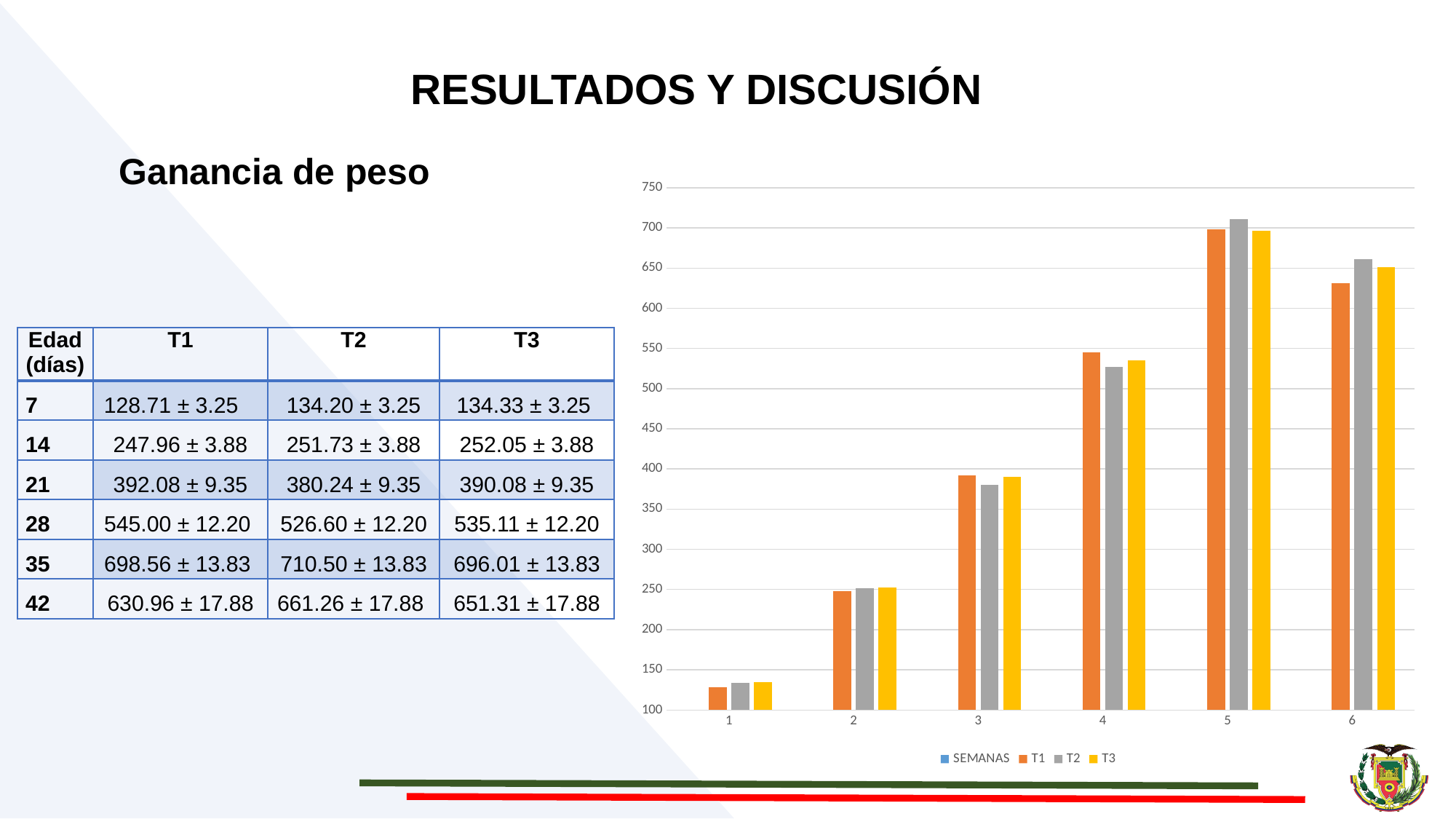
Which category has the shortest T2 bar in the chart? 1 At category 6, which is larger, T1 or T2? T2 How many entries does the chart legend list? 4 How many categories are shown on the x axis of the chart? 6 At category 4, which is larger, T1 or T2? T1 Is the T1 value for category 6 greater or less than 650? less What kind of chart is shown on the slide? bar chart Is the T1 value for category 1 greater or less than 150? less Which category has the tallest T1 bar in the chart? 5 Is the T3 value for category 4 greater or less than 500? greater Do the T3 values rise or fall from category 1 to category 5? rise